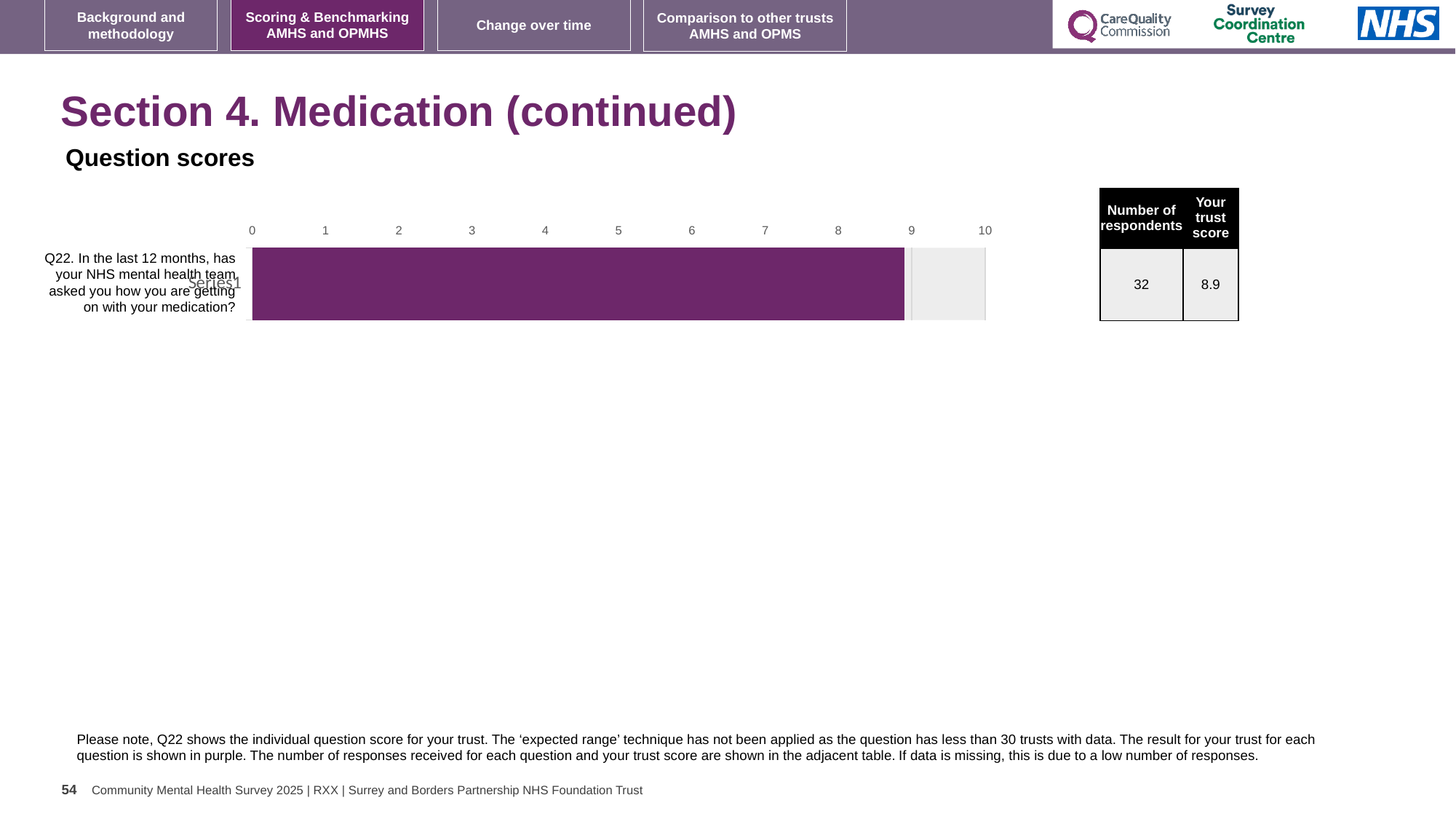
What colour is the bar for Q22? purple How many respondents answered Q22 according to the adjacent table? 32 How many bars are plotted in the chart? 1 What is the trust score for Q22 shown in the adjacent table? 8.9 What is the maximum value shown on the chart's horizontal axis? 10 Is the value for Q22 greater or less than 5? greater What kind of chart is shown on the slide? bar chart Is the value for Q22 greater or less than 8? greater